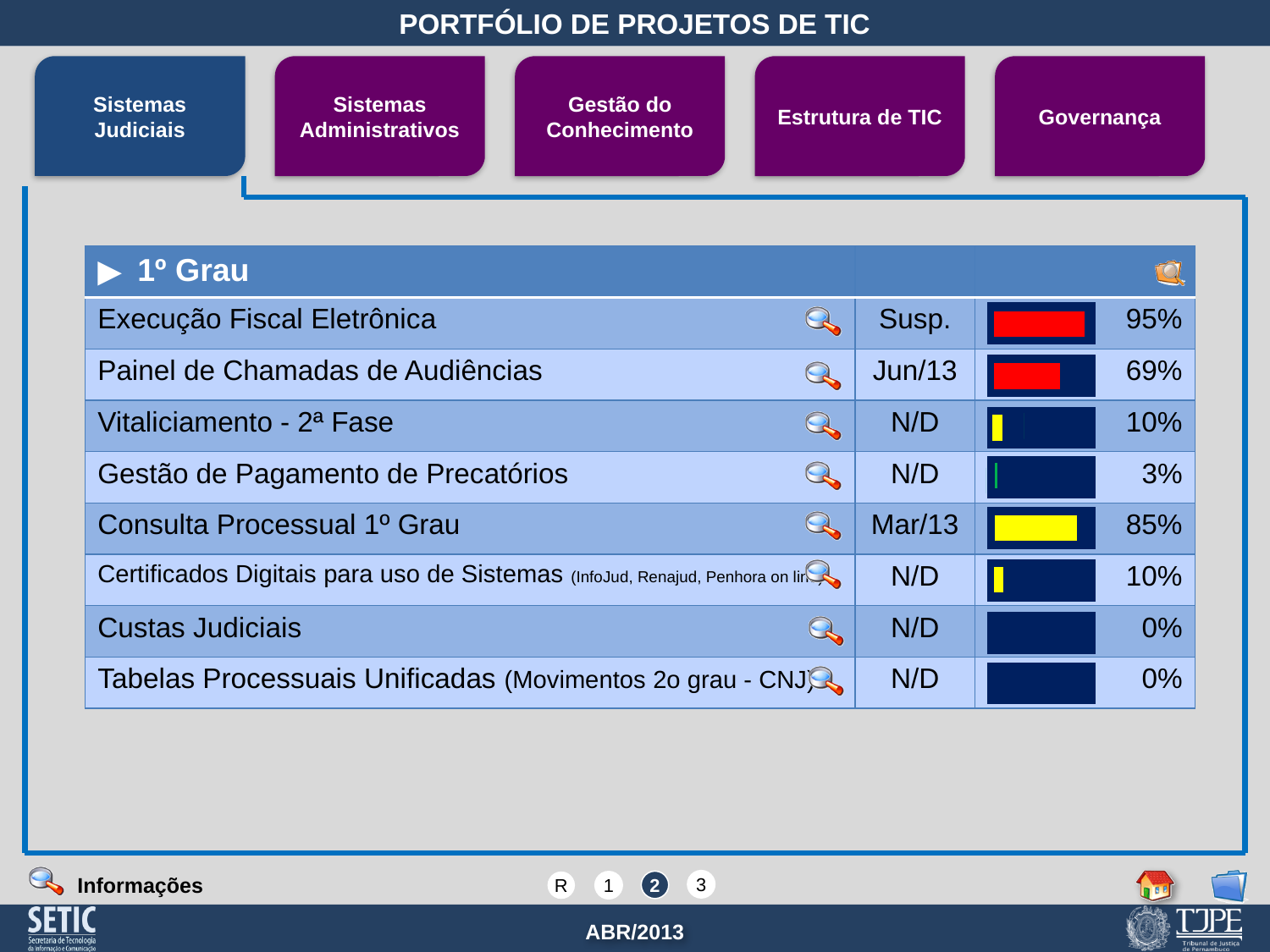
What completion percentage is shown for Consulta Processual 1º Grau? 85% What is the difference in percentage points between Execução Fiscal Eletrônica and Painel de Chamadas de Audiências? 26 How many projects in the 1º Grau table show 0% completion? 2 Which project in the 1º Grau table has the highest completion percentage? Execução Fiscal Eletrônica What kind of chart is used to show each project's completion in the table? Bar chart What is the expected date shown for Painel de Chamadas de Audiências? Jun/13 What colour is the progress bar for Consulta Processual 1º Grau? Yellow What completion percentage is shown for Gestão de Pagamento de Precatórios? 3% Which has a higher completion percentage, Consulta Processual 1º Grau or Painel de Chamadas de Audiências? Consulta Processual 1º Grau How many projects are listed in the 1º Grau table? 8 What completion percentage is shown for Execução Fiscal Eletrônica? 95% What completion percentage is shown for Painel de Chamadas de Audiências? 69%